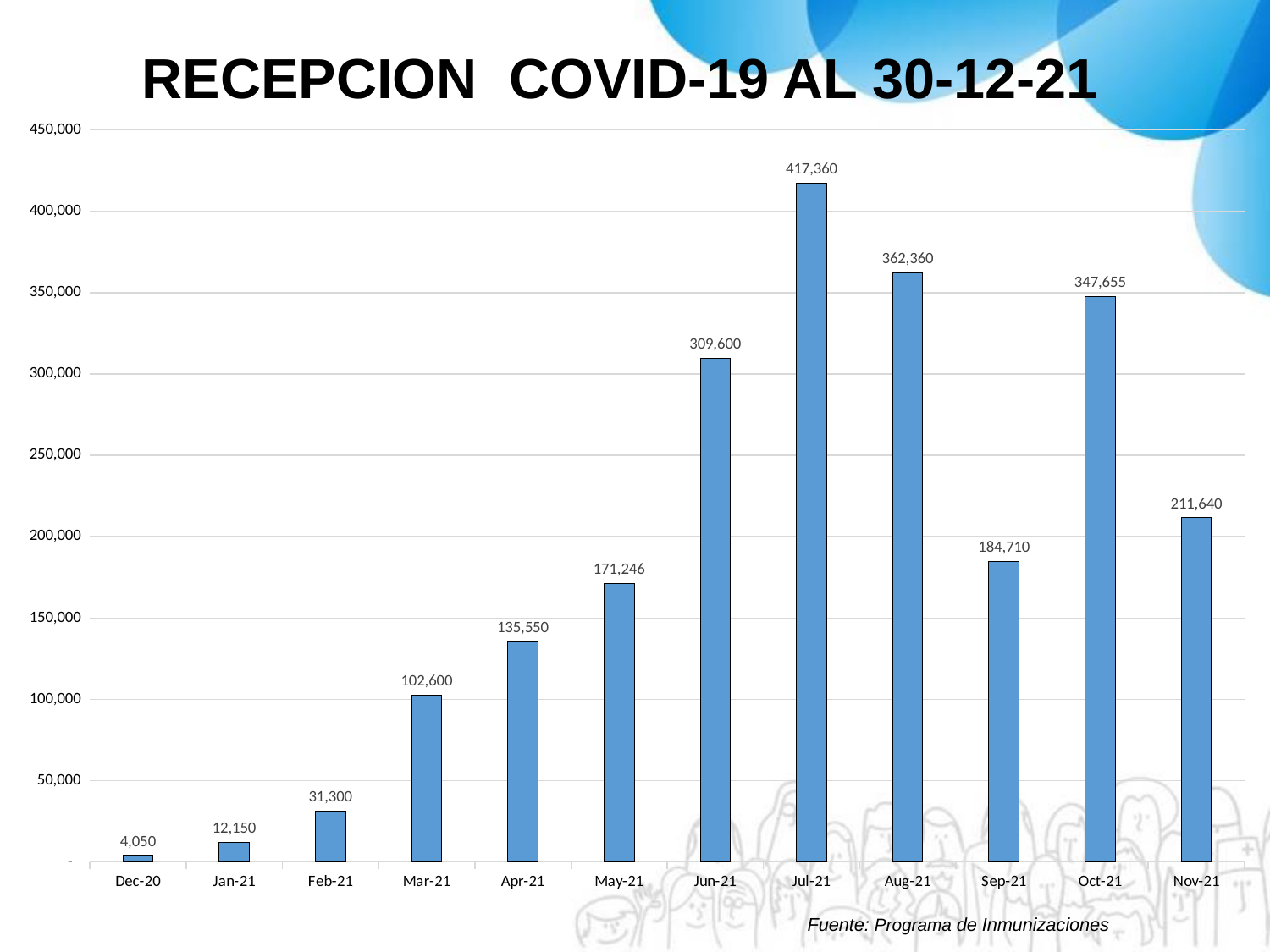
Is the value for May-21 greater or less than 150,000? greater What is the value for Mar-21? 102,600 What is the value for Jul-21? 417,360 Which month has the highest value? Jul-21 What is the value for Nov-21? 211,640 What kind of chart is shown on the slide? bar chart Which month has the lowest value? Dec-20 What is the difference between the values for Oct-21 and Sep-21? 162,945 How many months are shown on the x axis? 12 What is the difference between the values for Jul-21 and Aug-21? 55,000 Which is larger, the value for Jun-21 or the value for Oct-21? Oct-21 What is the title of the chart? RECEPCION COVID-19 AL 30-12-21